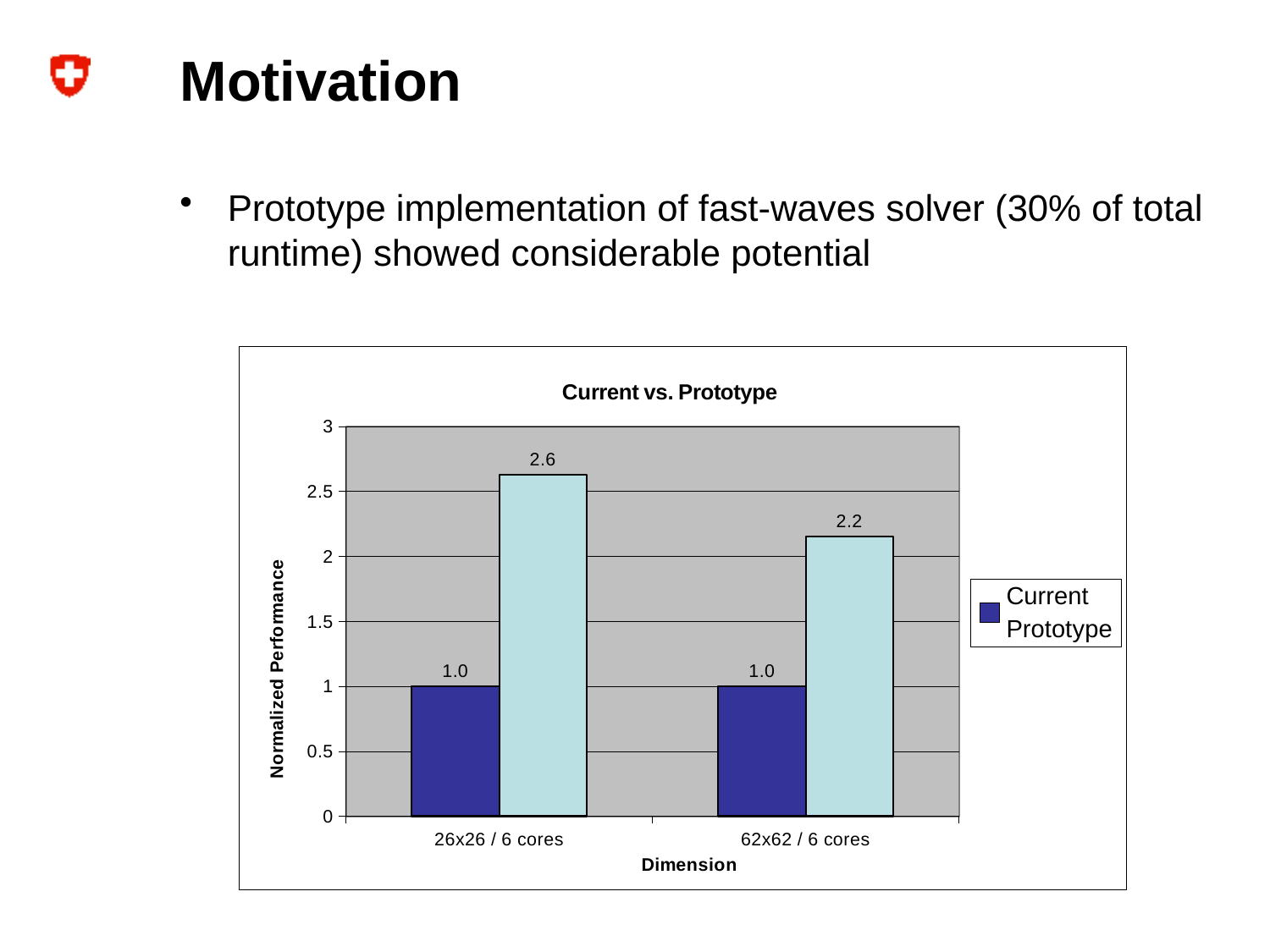
Which dimension has the lowest Prototype value? 62x62 / 6 cores Which dimension has the highest Prototype value? 26x26 / 6 cores What is the difference between the Prototype values for 26x26 / 6 cores and 62x62 / 6 cores? 0.4 What is the title of the chart? Current vs. Prototype What is the Current value for 26x26 / 6 cores? 1.0 What is the Prototype value for 62x62 / 6 cores? 2.2 Which is larger for 62x62 / 6 cores, the Current value or the Prototype value? Prototype What kind of chart is shown? Bar chart What is the Prototype value for 26x26 / 6 cores? 2.6 How many dimension categories are shown on the x axis? 2 How many series does the legend list? 2 What is the difference between the Prototype and Current values for 26x26 / 6 cores? 1.6